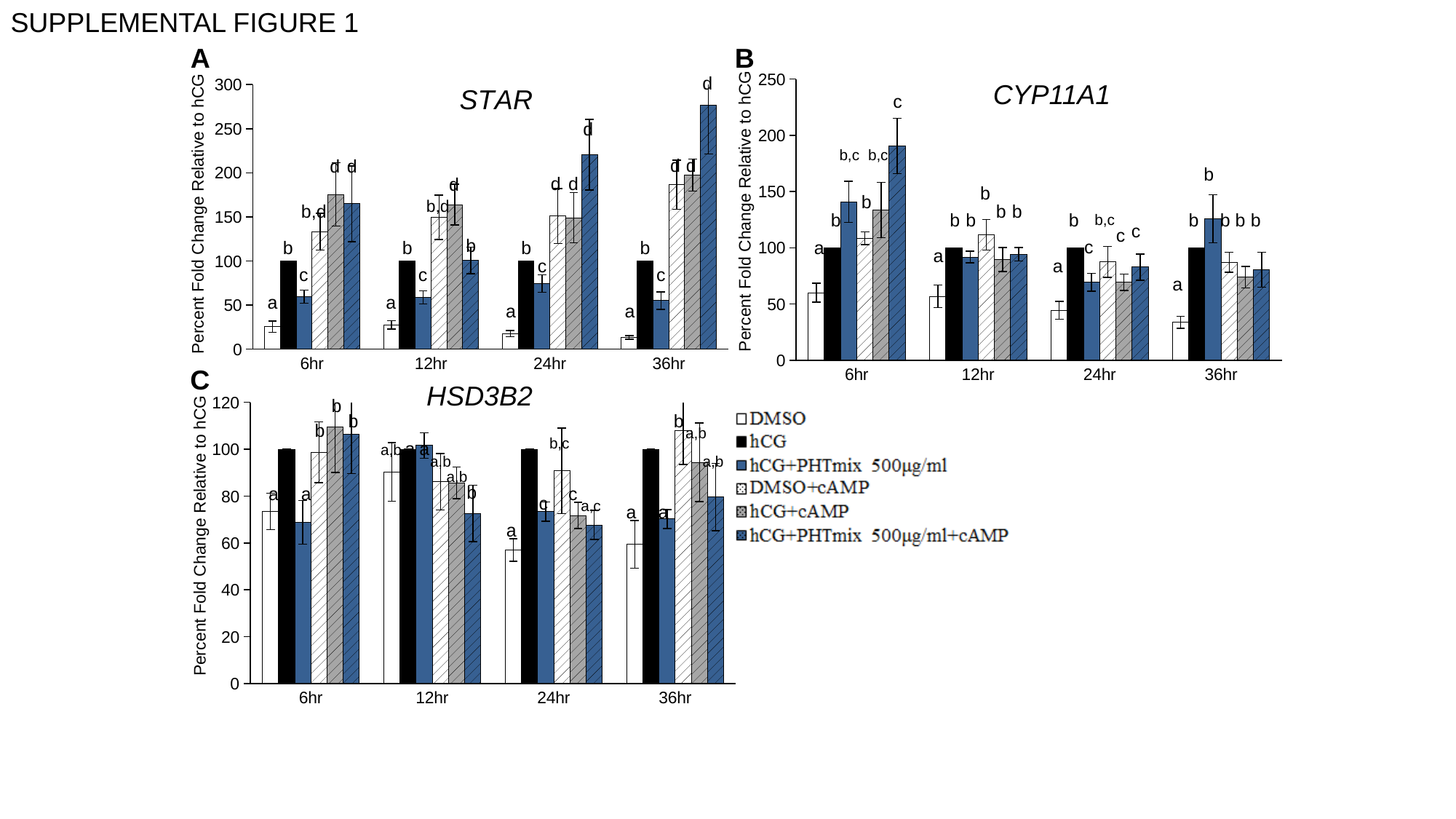
How many series does the legend list? 6 In the STAR chart (panel A), is the value for hCG+PHTmix 500µg/ml+cAMP at 36hr greater or less than 250? greater In the STAR chart (panel A), at which time point is the hCG+PHTmix 500µg/ml+cAMP bar highest? 36hr How many time points are shown on the x axis of the CYP11A1 chart (panel B)? 4 In the HSD3B2 chart (panel C), what is the value for hCG at 24hr? 100 In the STAR chart (panel A), what is the value for hCG at 12hr? 100 In the CYP11A1 chart (panel B), is the value for hCG+PHTmix 500µg/ml+cAMP at 6hr greater or less than 150? greater In the STAR chart (panel A), is the value for DMSO at 6hr greater or less than 50? less In the CYP11A1 chart (panel B), at which time point is the DMSO bar lowest? 36hr In the STAR chart (panel A), which is larger: the hCG+PHTmix 500µg/ml+cAMP value at 24hr or at 6hr? 24hr What kind of chart is the STAR chart (panel A)? bar chart